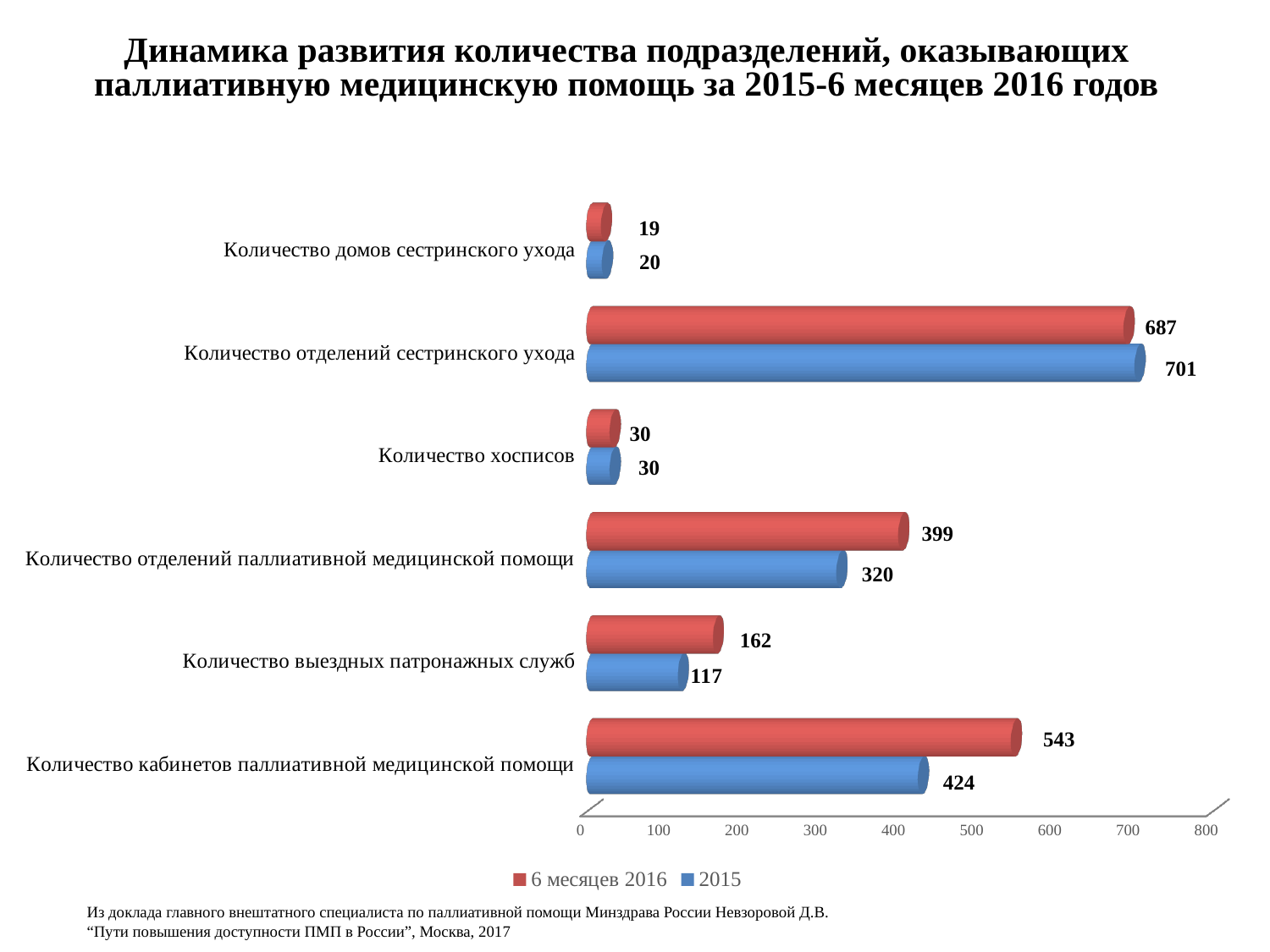
What is the value for "Количество выездных патронажных служб" in the "2015" series? 117 How many categories are shown on the chart? 6 Which category has the highest value in the "2015" series? Количество отделений сестринского ухода What kind of chart is shown on the slide? Bar chart How many series does the legend list? 2 Which category has the lowest value in the "6 месяцев 2016" series? Количество домов сестринского ухода For "Количество выездных патронажных служб", which series has the larger value: "6 месяцев 2016" or "2015"? 6 месяцев 2016 What is the value for "Количество отделений сестринского ухода" in the "6 месяцев 2016" series? 687 What is the value for "Количество кабинетов паллиативной медицинской помощи" in the "2015" series? 424 What is the difference between the "6 месяцев 2016" and "2015" values for "Количество отделений паллиативной медицинской помощи"? 79 What is the difference between the "6 месяцев 2016" and "2015" values for "Количество кабинетов паллиативной медицинской помощи"? 119 Which colour represents the "2015" series in the chart? Blue